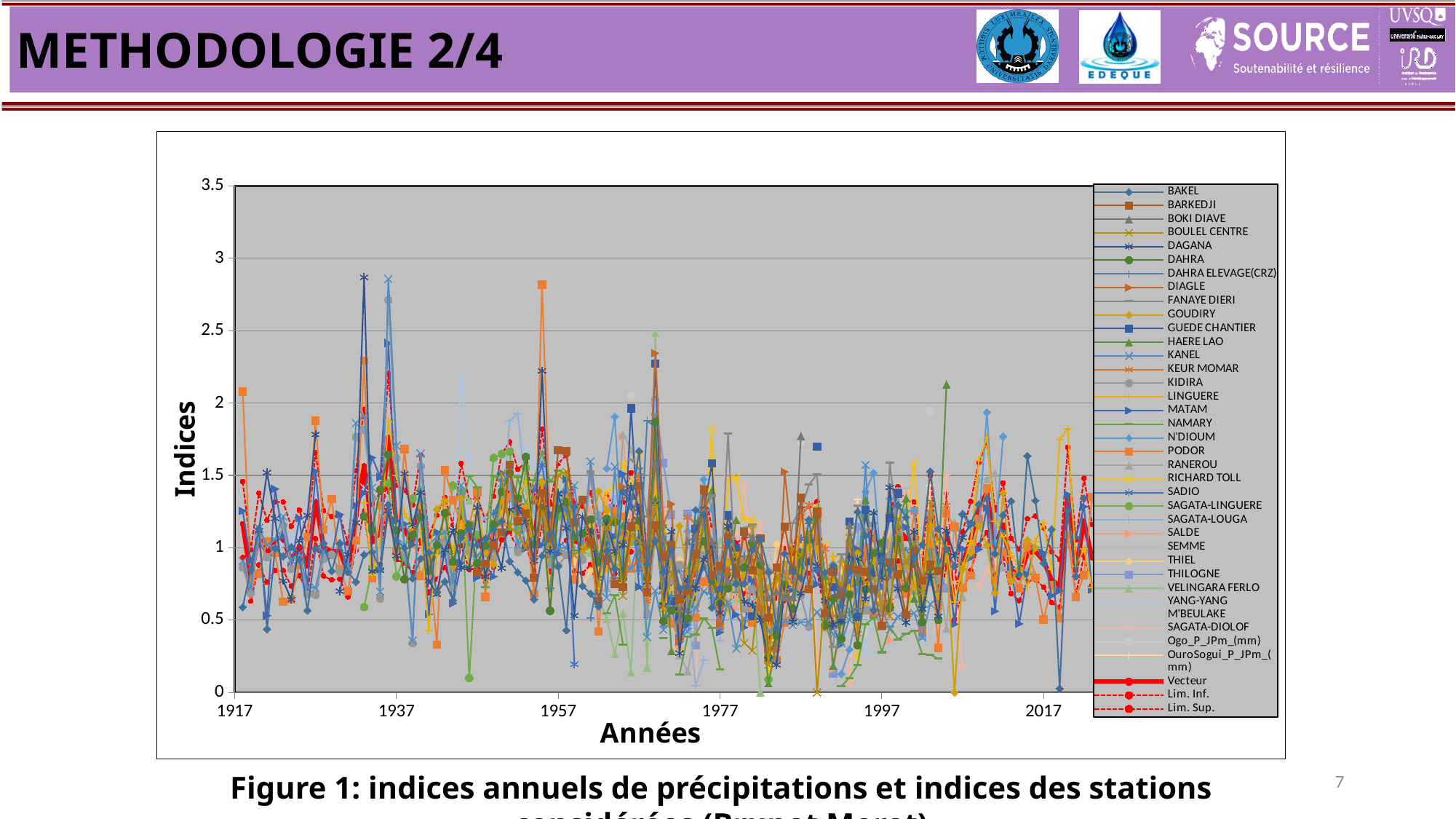
What is the lowest value shown on the y axis of the chart? 0 What is the label of the y axis of the chart? Indices How many series does the chart's legend list? 37 What is the first year shown on the x axis of the chart? 1917 What kind of chart is shown on the slide? line chart What is the label of the x axis of the chart? Années Which series is listed last in the chart's legend? Lim. Sup. Is the highest plotted value on the chart greater or less than 3? less What is the last year labelled on the x axis of the chart? 2017 Which series is listed first in the chart's legend? BAKEL What is the highest value shown on the y axis of the chart? 3.5